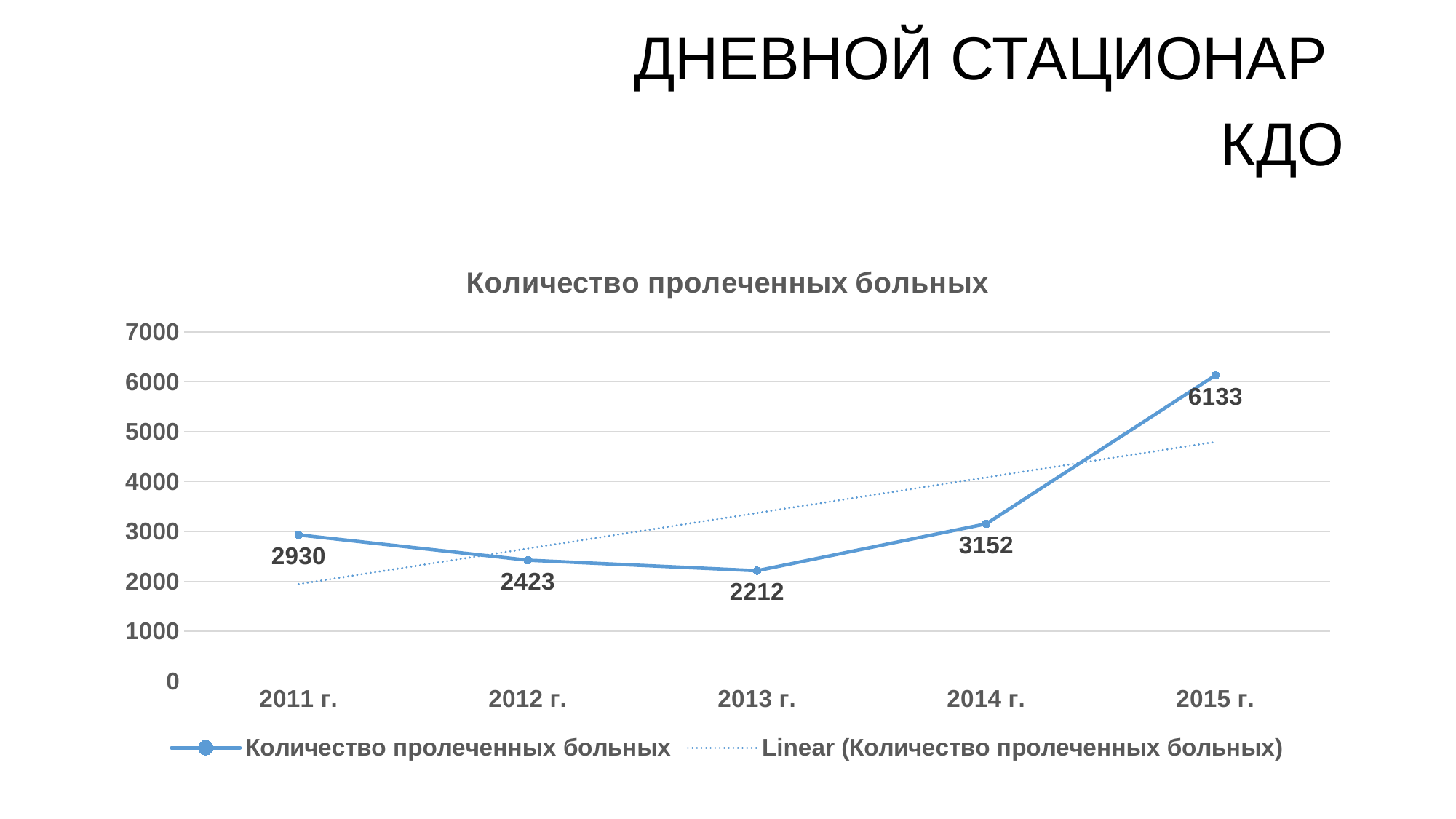
Which year has the highest number of treated patients? 2015 г. Which is larger, the value for 2012 г. or the value for 2014 г.? 2014 г. What is the value for 2011 г.? 2930 What kind of chart is shown on the slide? line chart What is the title of the chart? Количество пролеченных больных Is the value for 2015 г. greater or less than 6000? greater What is the difference between the values for 2011 г. and 2012 г.? 507 What is the difference between the values for 2015 г. and 2014 г.? 2981 Which year has the lowest number of treated patients? 2013 г. How many years are plotted on the chart? 5 What is the value for 2015 г.? 6133 What is the value for 2013 г.? 2212